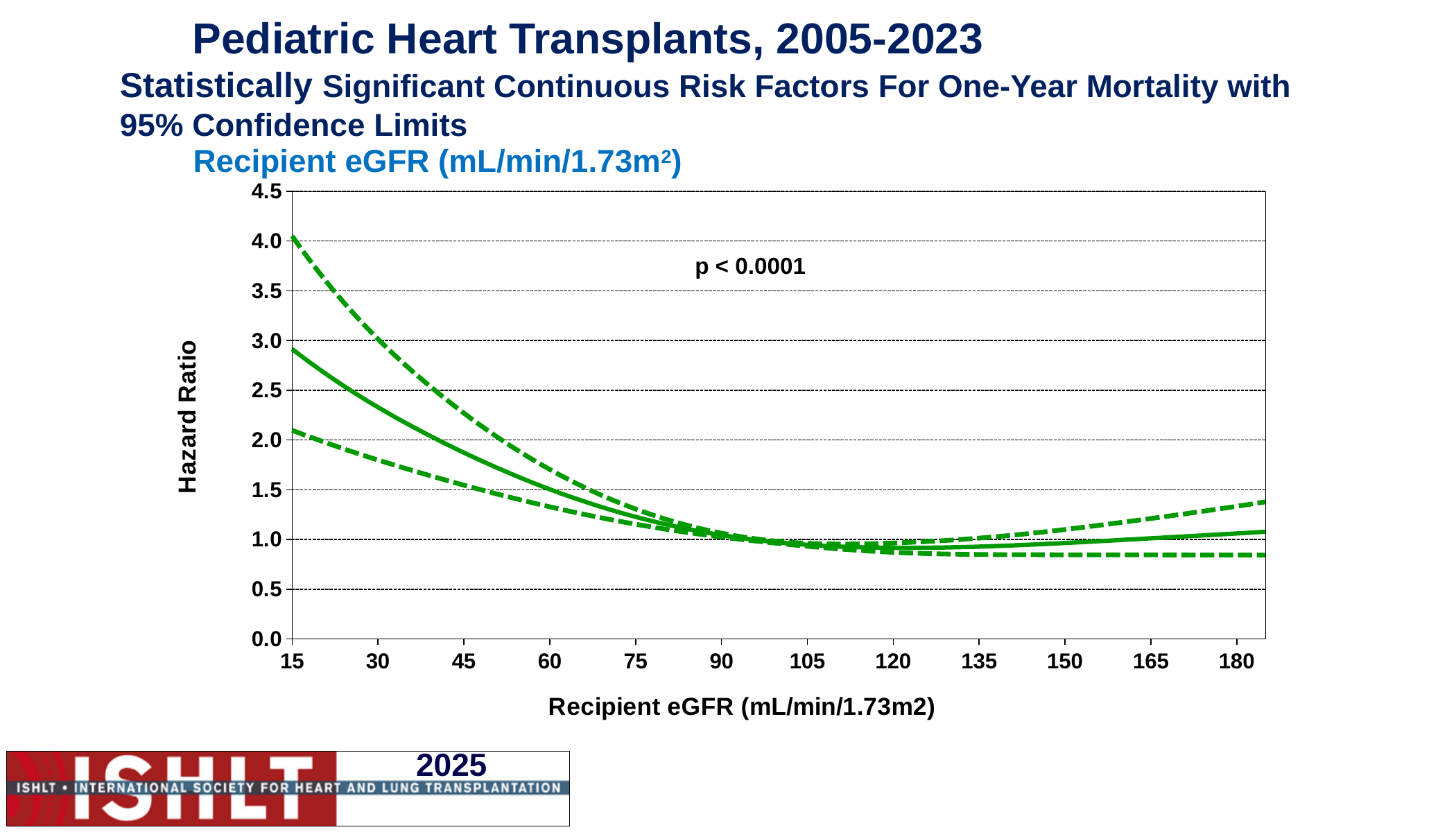
How many lines are plotted on the chart? 3 What kind of chart is shown on the slide? line chart Is the solid hazard ratio line at a recipient eGFR of 180 greater or less than 1.5? less What p-value is printed on the chart? p < 0.0001 Is the lower dashed confidence limit at a recipient eGFR of 15 greater or less than 2.5? less Is the solid hazard ratio line at a recipient eGFR of 30 greater or less than 2.0? greater Does the solid hazard ratio line rise or fall as recipient eGFR increases from 15 to 90? fall What is the label of the y axis? Hazard Ratio